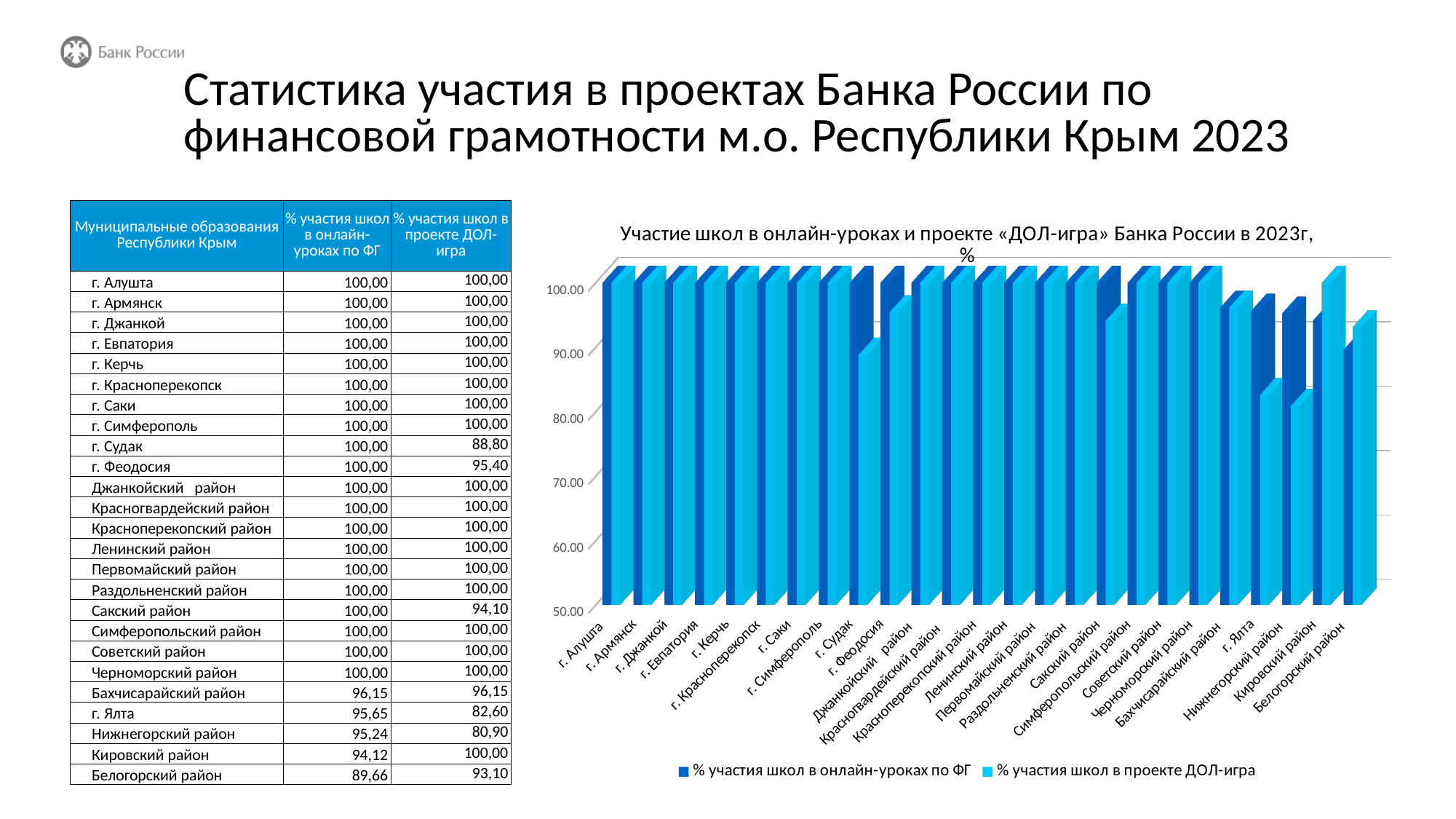
Is the value of % участия школ в проекте ДОЛ-игра for г. Ялта greater or less than 90? less What kind of chart is shown on the slide? bar chart Which municipality has the lowest value for % участия школ в онлайн-уроках по ФГ? Белогорский район What is the title of the chart? Участие школ в онлайн-уроках и проекте «ДОЛ-игра» Банка России в 2023г, % How many municipalities (categories) are plotted on the x axis of the chart? 25 What is the value of % участия школ в проекте ДОЛ-игра for г. Ялта? 82,60 How many series does the chart legend list? 2 Which municipality has the lowest value for % участия школ в проекте ДОЛ-игра? Нижнегорский район What is the difference between % участия школ в онлайн-уроках по ФГ and % участия школ в проекте ДОЛ-игра for Нижнегорский район? 14,34 What is the value of % участия школ в онлайн-уроках по ФГ for Белогорский район? 89,66 Is the value of % участия школ в проекте ДОЛ-игра for Сакский район greater or less than 90? greater For г. Судак, which is larger: % участия школ в онлайн-уроках по ФГ or % участия школ в проекте ДОЛ-игра? % участия школ в онлайн-уроках по ФГ